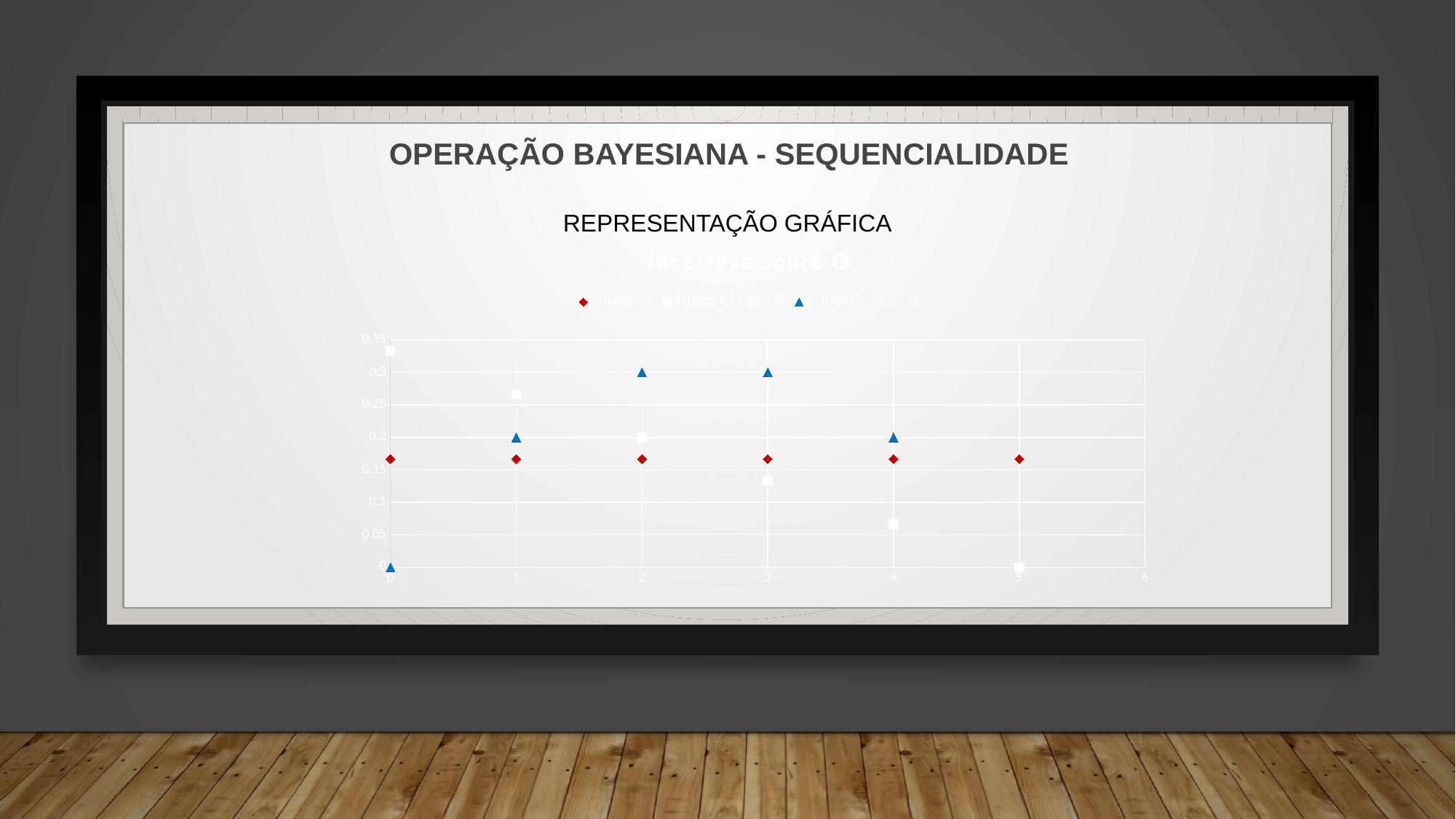
What is the value of the white square series P(theta = j | X1 = 0) at x = 2? 0.2 How many red diamond points are plotted for the series P(theta = j)? 6 Is the value of the white square series P(theta = j | X1 = 0) at x = 0 greater or less than 0.3? greater What is the value of the blue triangle series P*(theta = j | X2 = 1) at x = 2? 0.3 Do the values of the white square series P(theta = j | X1 = 0) rise or fall as x increases from 0 to 5? fall What kind of chart is shown on the slide? scatter chart At x = 3, which series has the larger value: the blue triangle series or the white square series? blue triangle series (P*(theta = j | X2 = 1)) Is the value of the red diamond series P(theta = j) at x = 3 greater or less than 0.2? less What is the title of the chart? incerteza sobre Θ How many series does the chart legend list? 3 What is the value of the blue triangle series P*(theta = j | X2 = 1) at x = 1? 0.2 At which x value is the white square series P(theta = j | X1 = 0) highest? 0